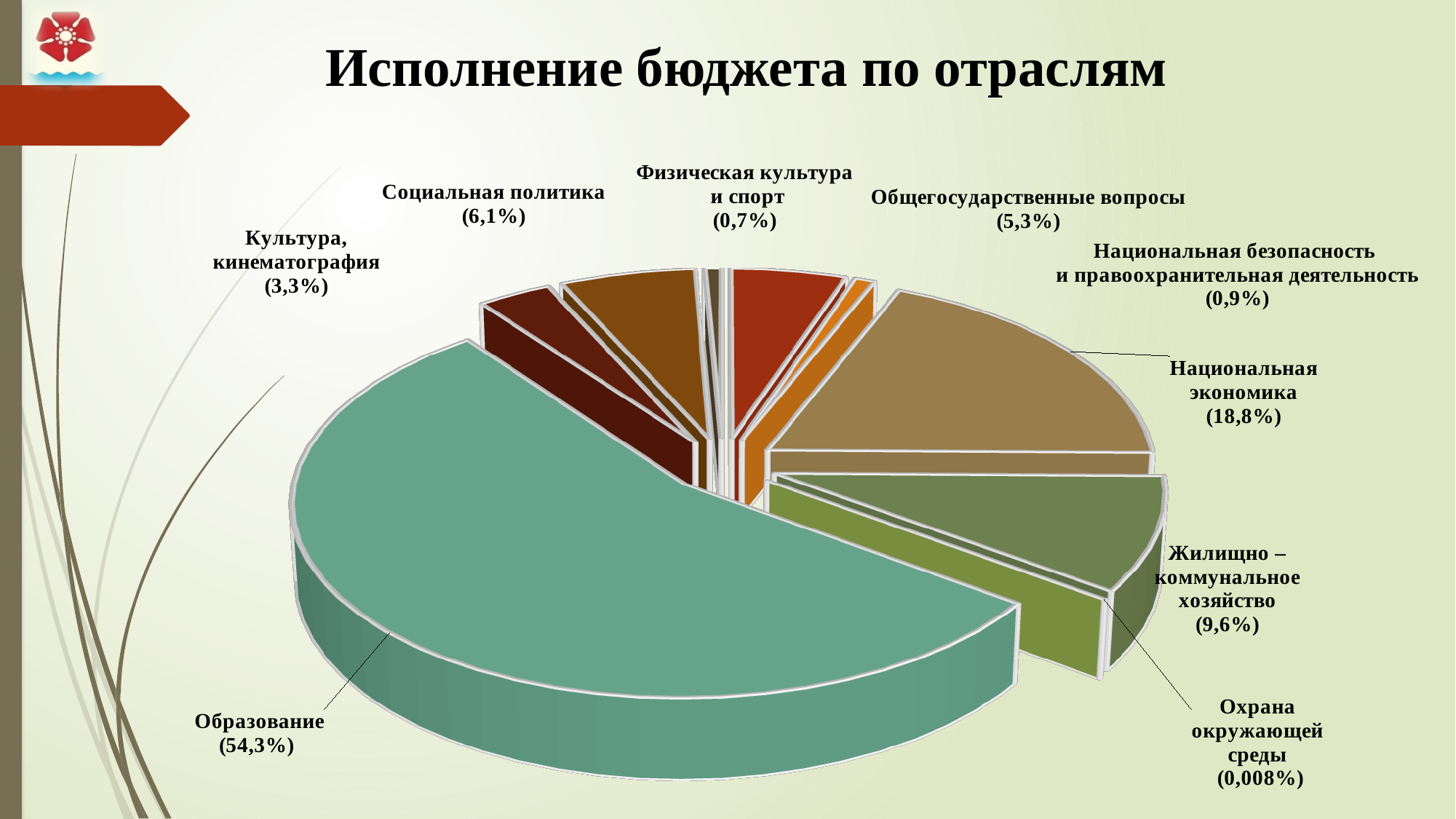
What kind of chart is shown on the slide? Pie chart What is the value shown for Национальная экономика? 18,8% Which sector has the smallest share of the budget? Охрана окружающей среды What is the value shown for Физическая культура и спорт? 0,7% What is the title of the chart? Исполнение бюджета по отраслям Which sector has the largest share of the budget? Образование What is the difference in percentage points between Образование and Национальная экономика? 35,5 Which is larger: Социальная политика or Общегосударственные вопросы? Социальная политика What percentage is shown for Жилищно-коммунальное хозяйство? 9,6% What is the value for Охрана окружающей среды? 0,008% What share of the budget goes to Образование? 54,3% How many sectors are shown in the pie chart? 9